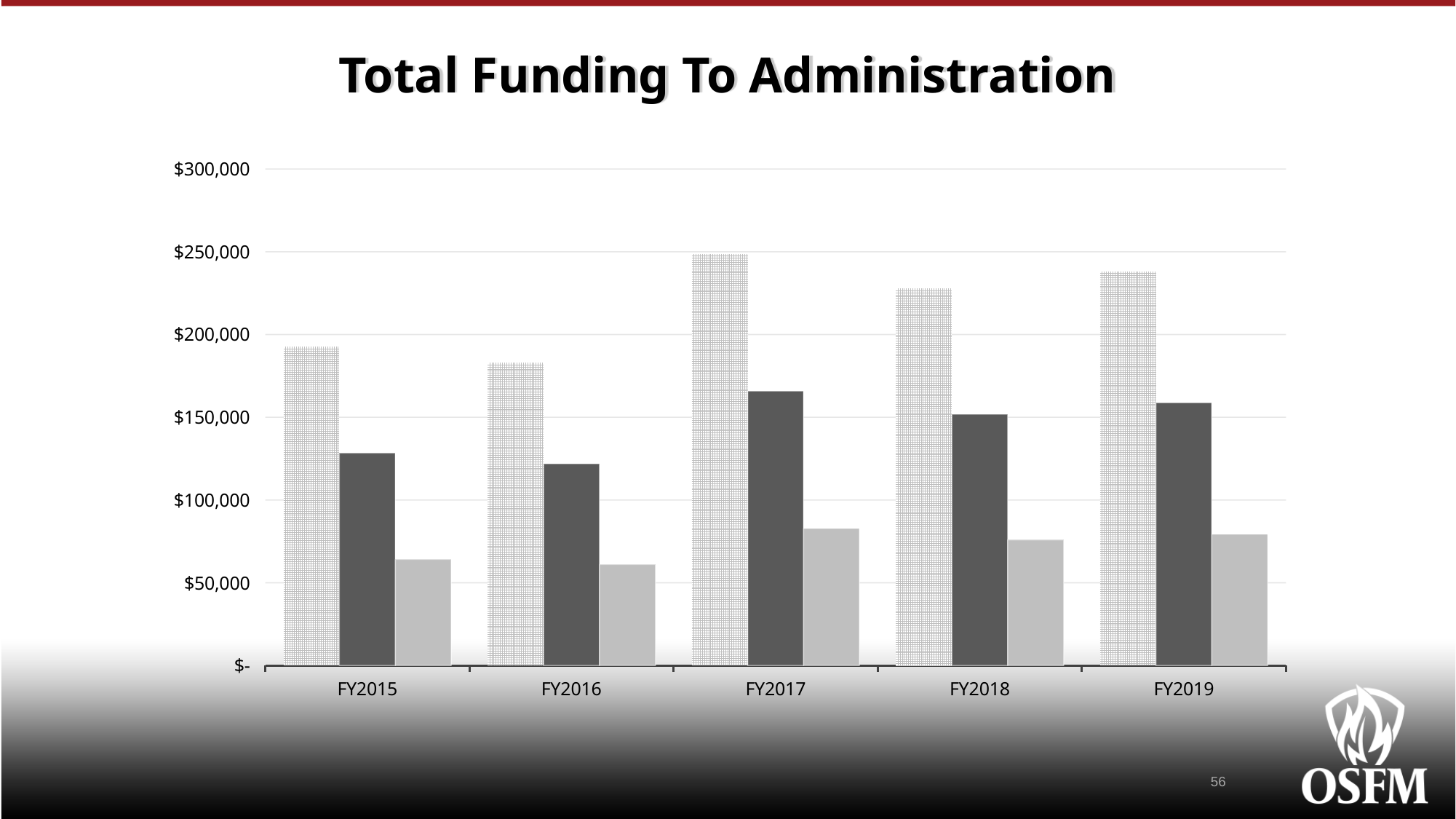
What kind of chart is shown on the slide? Bar chart How many fiscal years are shown on the x axis? 5 Which is larger, the dotted bar for FY2018 or the dotted bar for FY2019? FY2019 Is the value of the dotted bar for FY2016 greater or less than $200,000? less Is the value of the light gray bar for FY2017 greater or less than $100,000? less In which fiscal year is the dotted (patterned) bar the shortest? FY2016 In which fiscal year is the dotted (patterned) bar the tallest? FY2017 In which fiscal year is the dark gray bar the tallest? FY2017 Is the value of the dark gray bar for FY2017 greater or less than $150,000? greater How many bars are plotted for each fiscal year? 3 What is the title of the chart? Total Funding To Administration